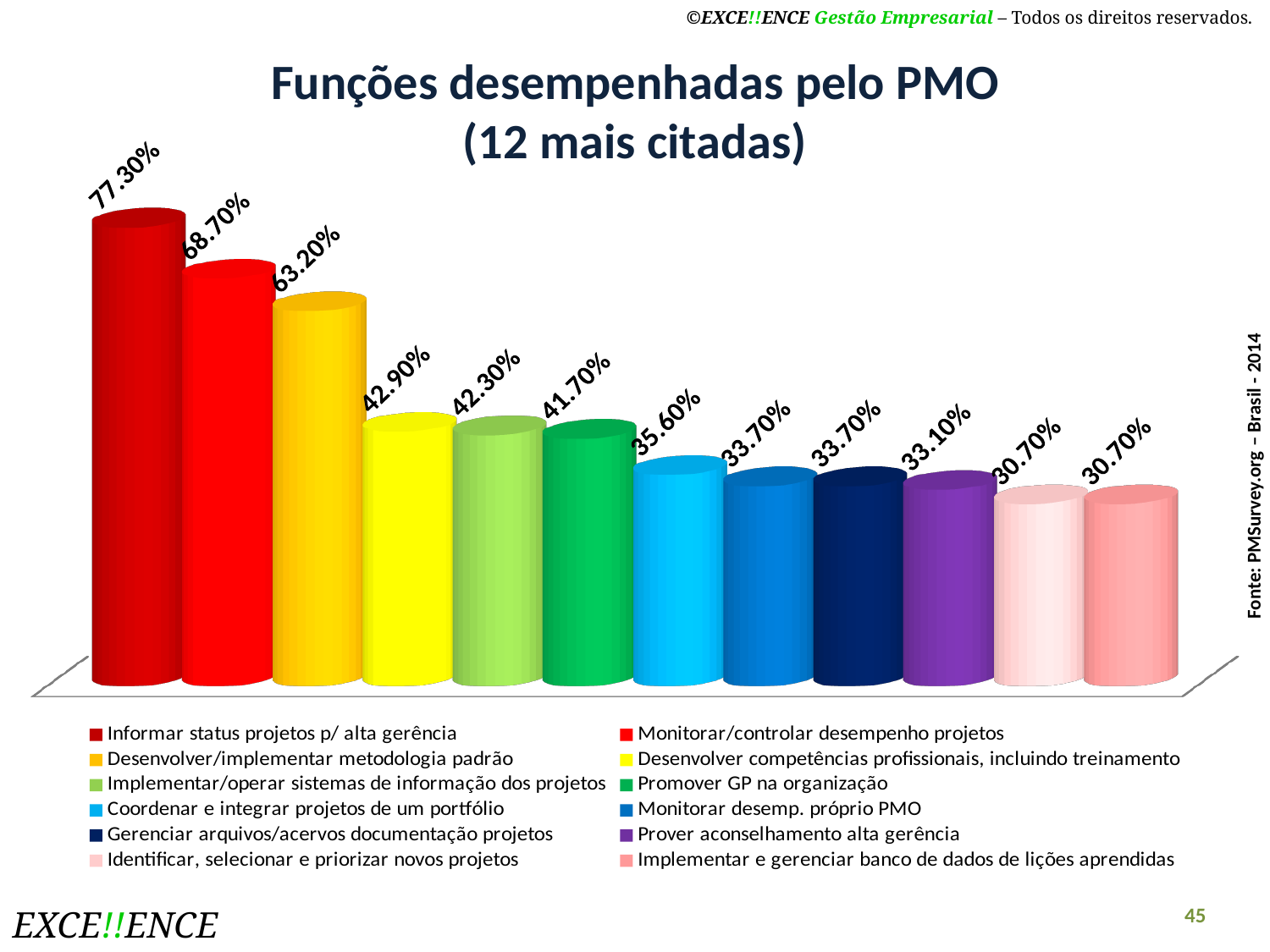
Which function has the highest value? Informar status projetos p/ alta gerência Which is larger: "Promover GP na organização" or "Coordenar e integrar projetos de um portfólio"? Promover GP na organização What is the value for "Prover aconselhamento alta gerência"? 33.10% What is the difference between "Desenvolver/implementar metodologia padrão" and "Desenvolver competências profissionais, incluindo treinamento"? 20.30% How many entries does the legend list? 12 How many bars are plotted in the chart? 12 What is the value for "Desenvolver/implementar metodologia padrão"? 63.20% What is the value for "Informar status projetos p/ alta gerência"? 77.30% What is the difference between "Informar status projetos p/ alta gerência" and "Monitorar/controlar desempenho projetos"? 8.60% What is the value for "Coordenar e integrar projetos de um portfólio"? 35.60% Do the values rise or fall from left to right across the bars? Fall What kind of chart is shown on the slide? Bar chart